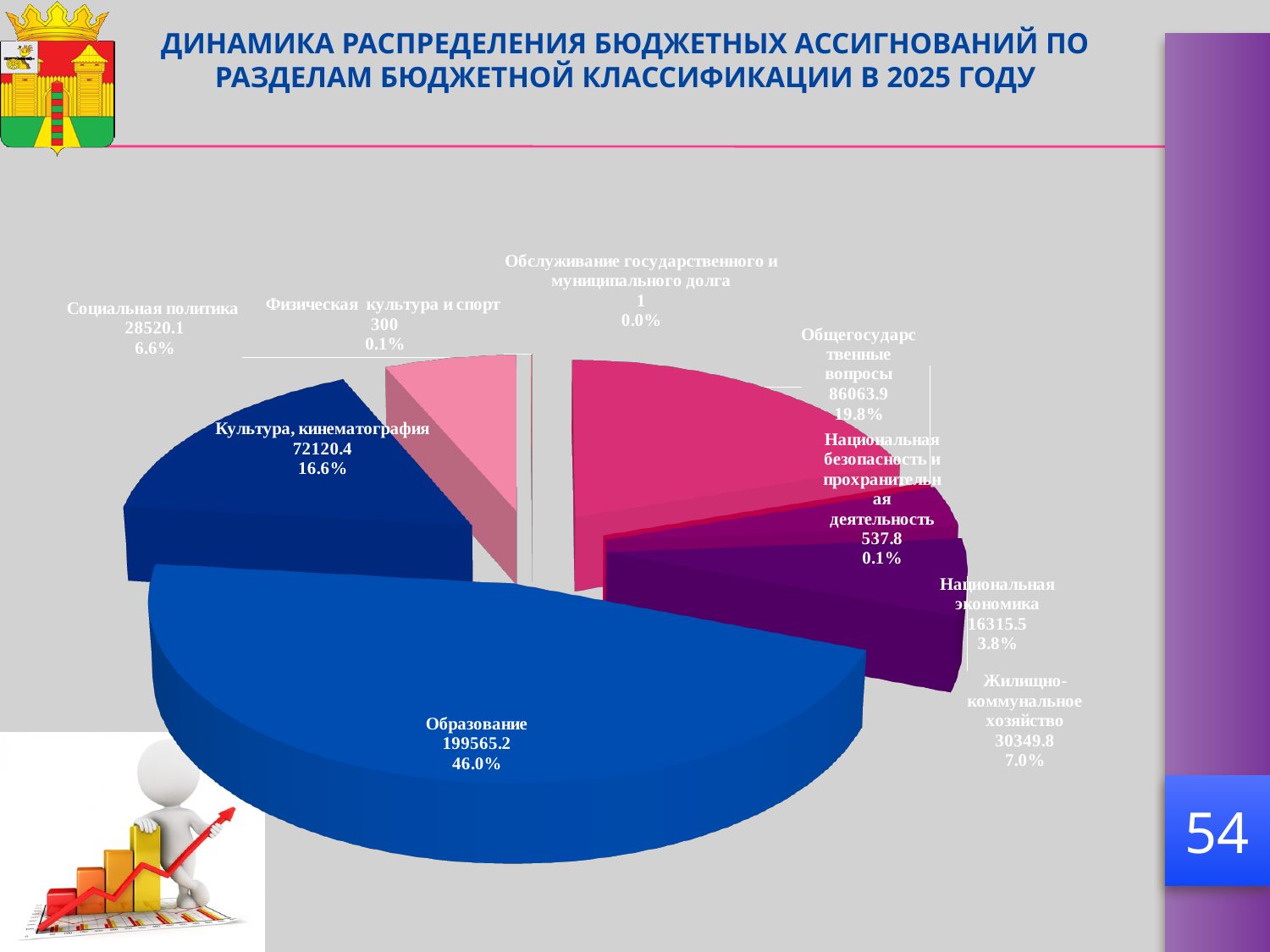
How many categories (slices) does the pie chart show? 9 Which is larger: the value for Жилищно-коммунальное хозяйство or the value for Национальная экономика? Жилищно-коммунальное хозяйство What is the value shown for Общегосударственные вопросы? 86063.9 What kind of chart is shown on the slide? Pie chart What is the difference between the values for Образование and Культура, кинематография? 127444.8 What share of the pie does Образование represent? 46.0% Which category has the smallest value in the pie chart? Обслуживание государственного и муниципального долга What is the value shown for Образование? 199565.2 What is the value shown for Физическая культура и спорт? 300 What share of the pie does Культура, кинематография represent? 16.6% What is the title of the slide containing the pie chart? ДИНАМИКА РАСПРЕДЕЛЕНИЯ БЮДЖЕТНЫХ АССИГНОВАНИЙ ПО РАЗДЕЛАМ БЮДЖЕТНОЙ КЛАССИФИКАЦИИ В 2025 ГОДУ Which category has the largest slice of the pie? Образование